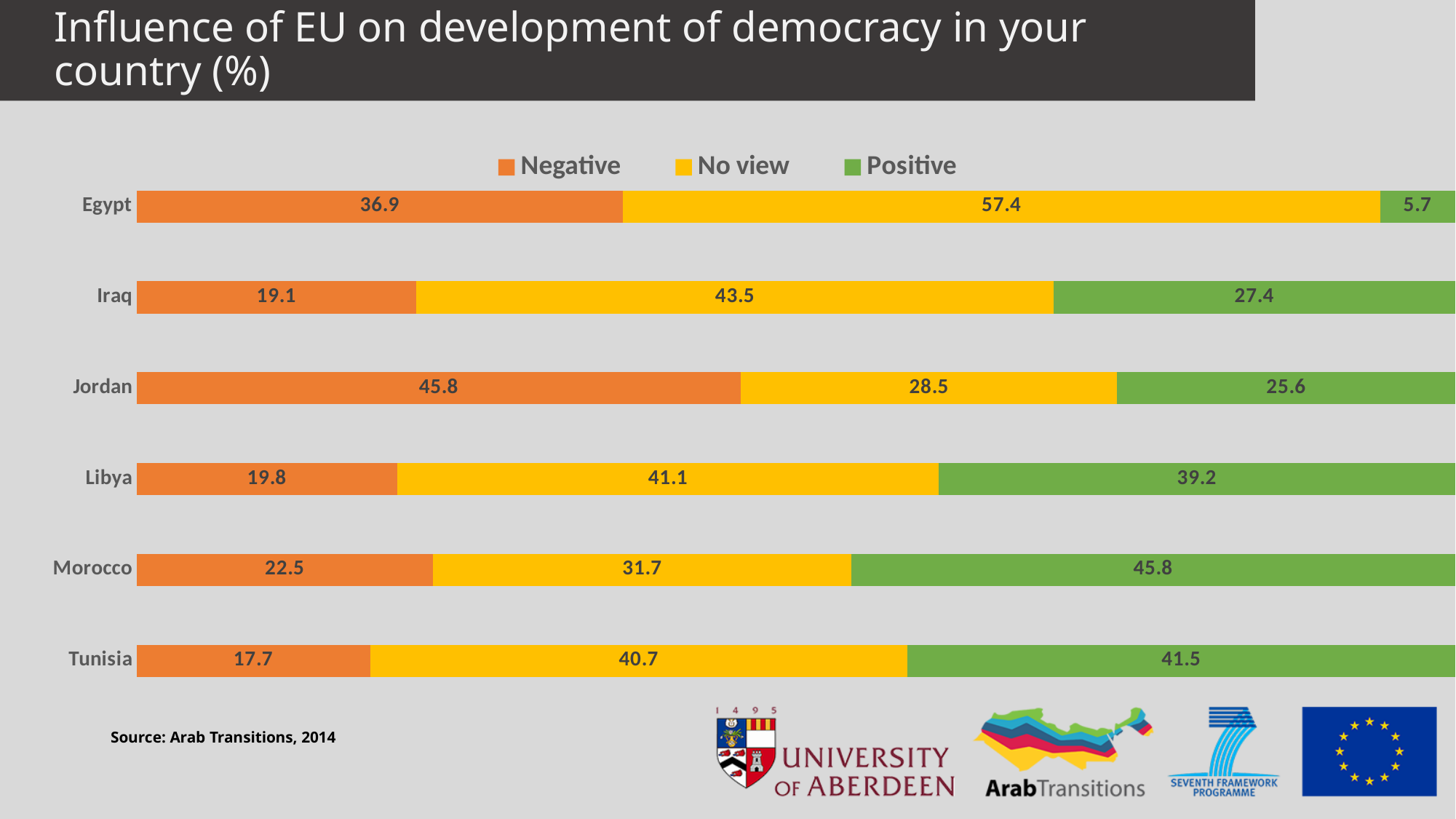
Which country has the highest Positive value? Morocco How many series does the legend list? 3 Which country has the lowest Positive value? Egypt What is the difference between the Positive values for Libya and Iraq? 11.8 How many countries are shown on the chart? 6 What is the No view value for Egypt? 57.4 Which country has the lowest Negative value? Tunisia Which is larger, the Negative value for Egypt or the Negative value for Morocco? Egypt What is the Negative value for Jordan? 45.8 What kind of chart is shown on the slide? Stacked bar chart What is the total of the stacked bar for Iraq? 90.0 What is the Positive value for Tunisia? 41.5